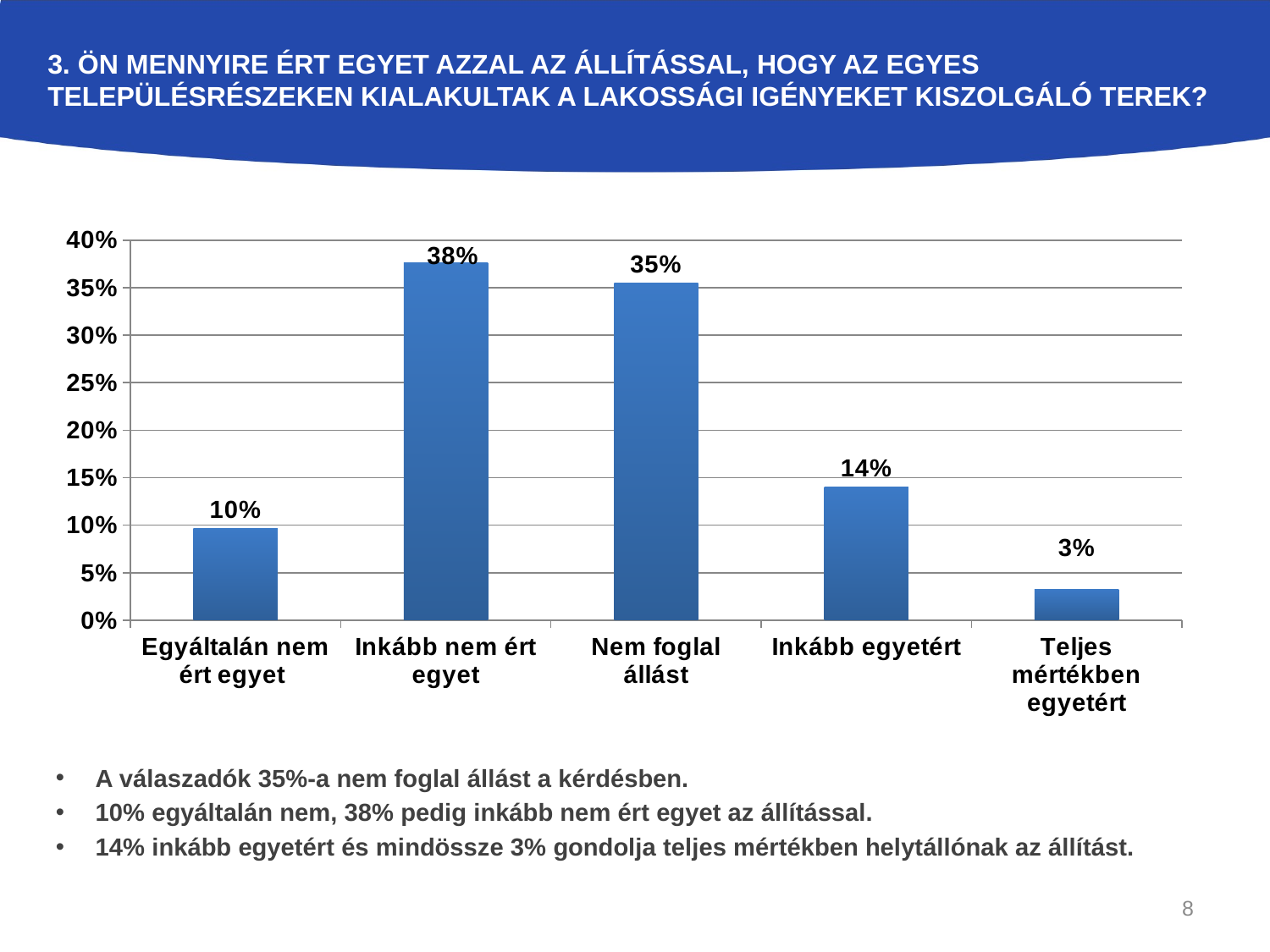
How many categories are shown on the x axis? 5 What is the value for "Nem foglal állást"? 35% Which is larger, the value for "Egyáltalán nem ért egyet" or the value for "Inkább egyetért"? Inkább egyetért What is the value for "Teljes mértékben egyetért"? 3% What is the difference between the values for "Inkább egyetért" and "Egyáltalán nem ért egyet"? 4% What is the difference between the values for "Inkább nem ért egyet" and "Nem foglal állást"? 3% Which category has the lowest value? Teljes mértékben egyetért What is the value for "Inkább nem ért egyet"? 38% What kind of chart is shown on the slide? bar chart Which category has the highest value? Inkább nem ért egyet Is the value for "Nem foglal állást" greater or less than 30%? greater What is the highest value shown on the y axis? 40%